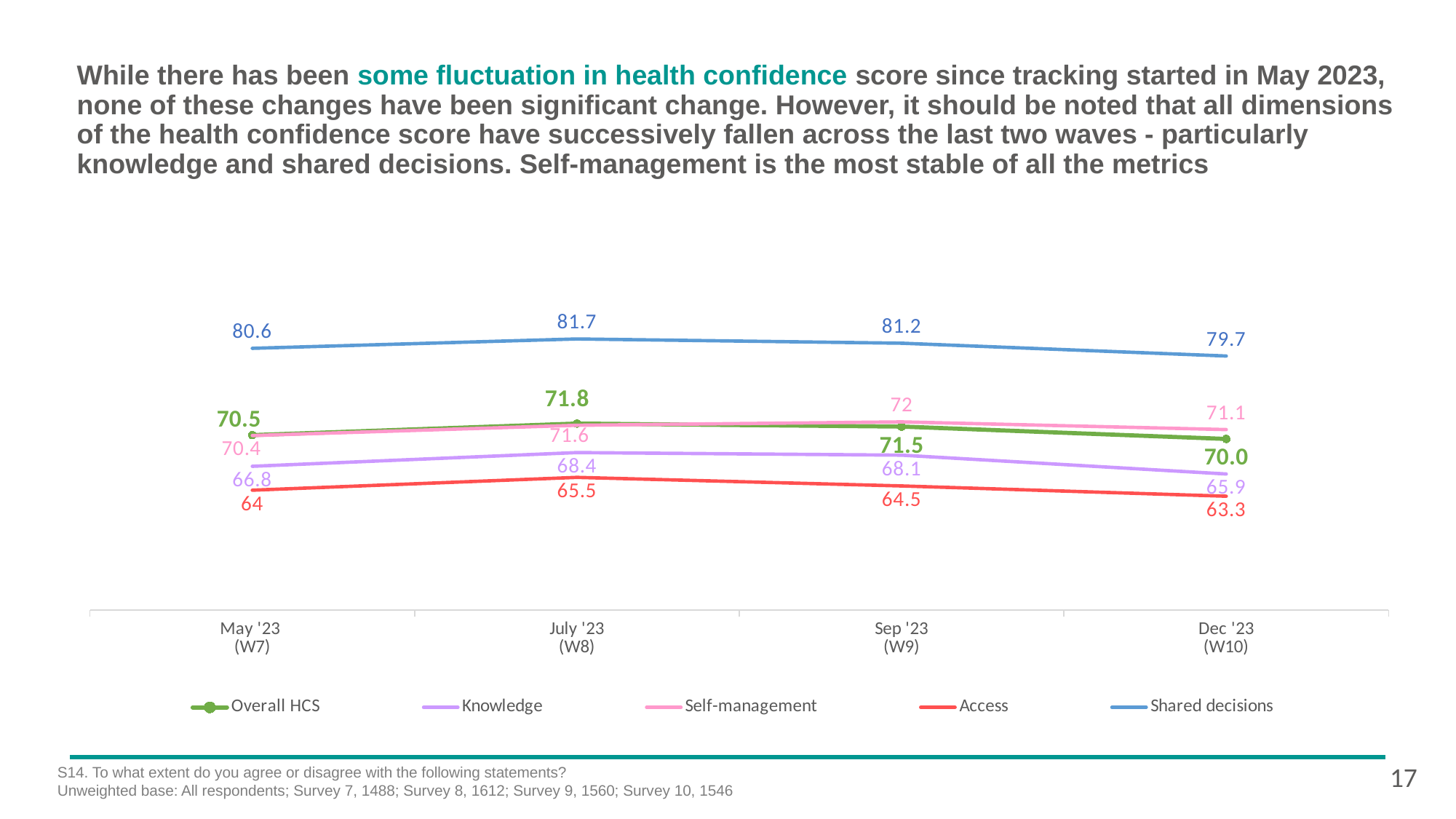
In which wave is the Shared decisions series highest? July '23 (W8) In which wave is the Access series lowest? Dec '23 (W10) What is the Overall HCS value for July '23 (W8)? 71.8 What is the Shared decisions value for Dec '23 (W10)? 79.7 What is the Knowledge value for Sep '23 (W9)? 68.1 What kind of chart is shown on the slide? Line chart Does the Knowledge series rise or fall from Sep '23 (W9) to Dec '23 (W10)? Fall Which is larger in Sep '23 (W9): Self-management or Overall HCS? Self-management What is the Access value for May '23 (W7)? 64 What is the difference between the Shared decisions value and the Access value in Dec '23 (W10)? 16.4 How many series does the legend list? 5 How many waves (time points) are shown on the x axis? 4